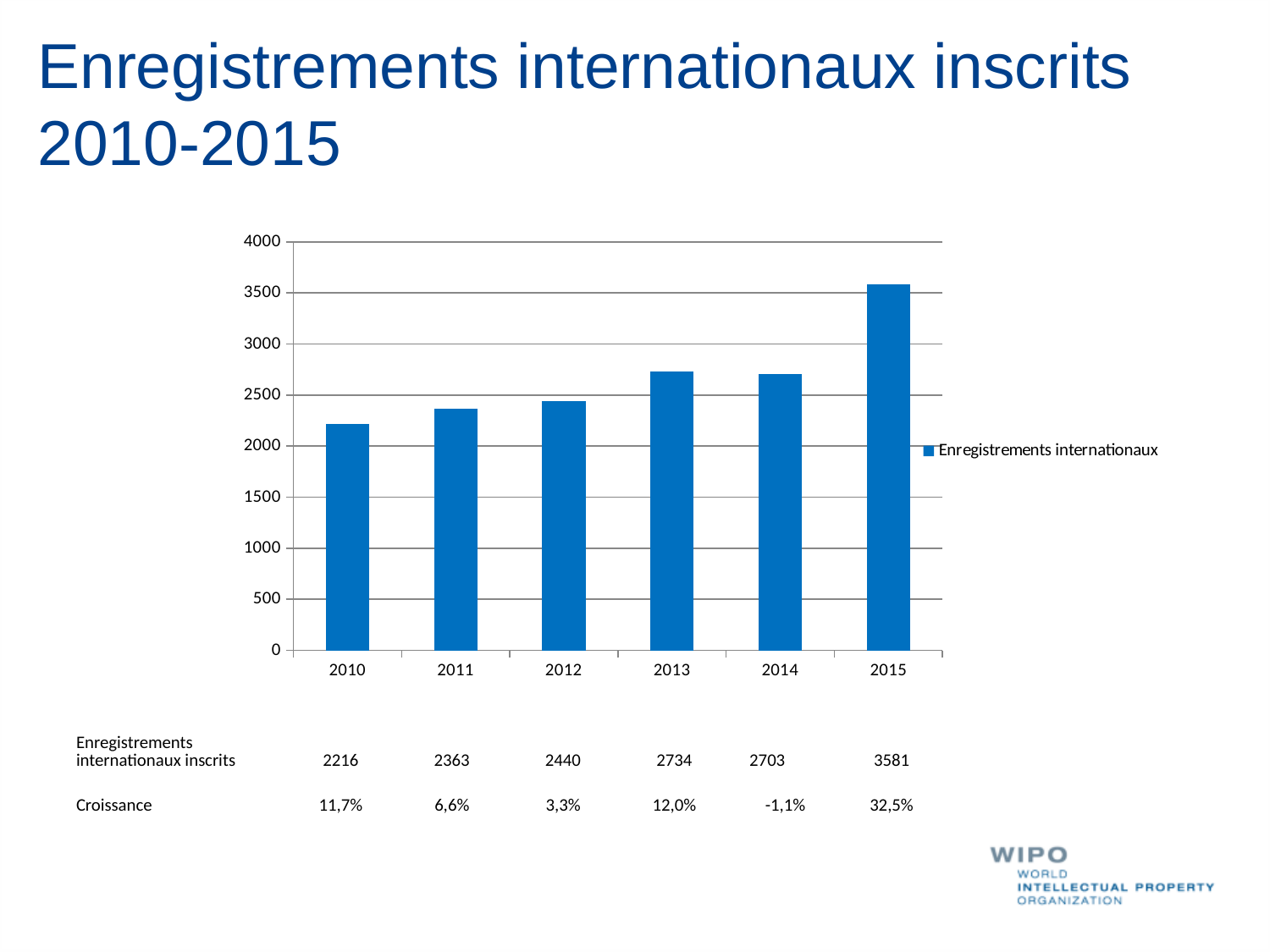
How many years are plotted on the x axis of the chart? 6 Which year has the highest number of international registrations? 2015 What is the legend entry shown on the chart? Enregistrements internationaux What type of chart is shown on the slide? bar chart What is the value of international registrations recorded for 2013? 2734 Which year has more international registrations, 2013 or 2014? 2013 How many series does the chart legend list? 1 What is the difference between the international registrations in 2015 and 2014? 878 What is the value of international registrations recorded for 2010? 2216 Which year has the lowest number of international registrations? 2010 Is the value for 2015 greater or less than 3500? greater What is the value of international registrations recorded for 2015? 3581